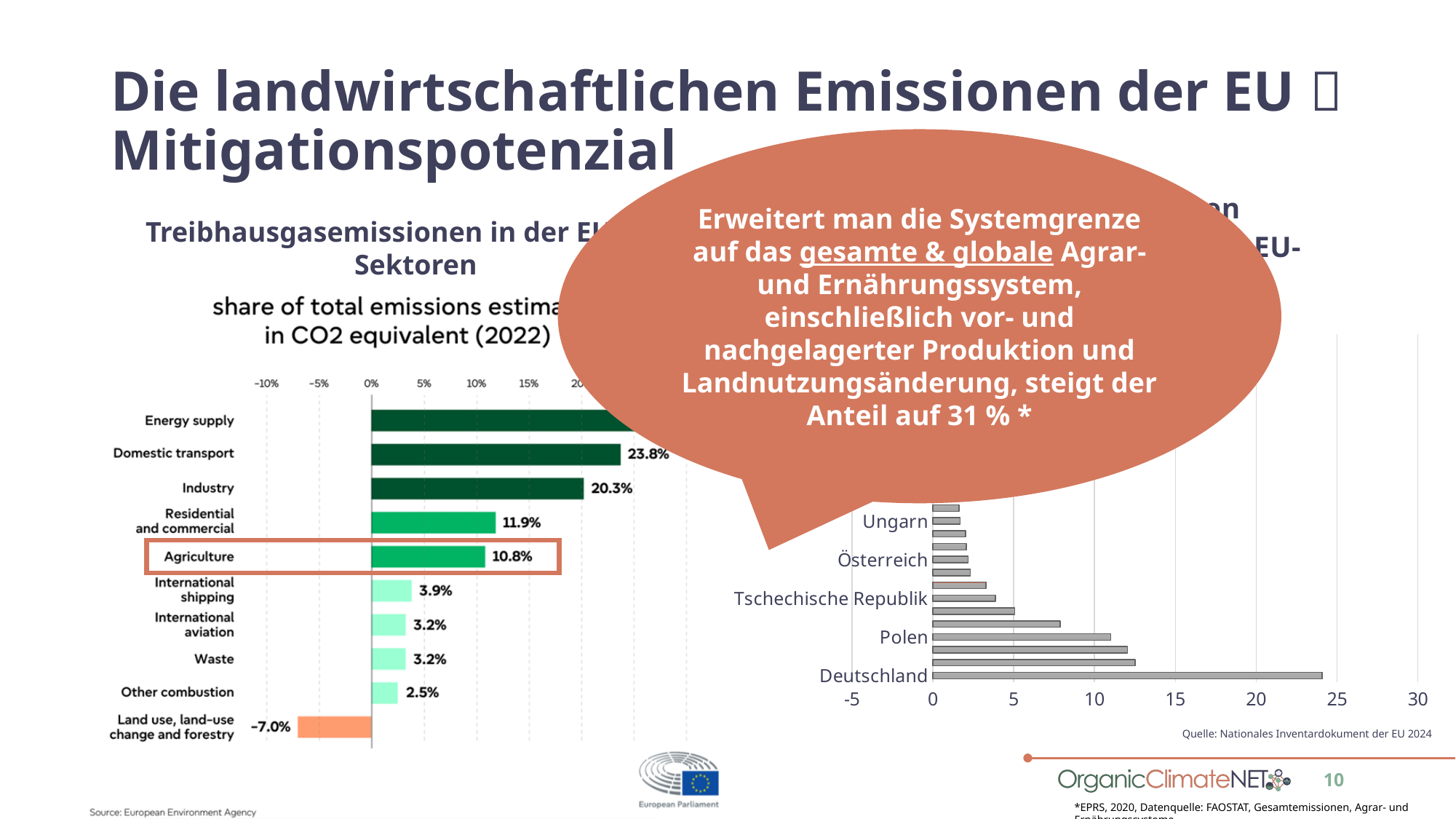
In the chart on the left, what is the value for Land use, land-use change and forestry? -7.0% In the chart on the left, which is larger: Residential and commercial or Agriculture? Residential and commercial How many sectors are shown in the chart on the left? 10 In the chart on the left, what is the difference between Domestic transport and Industry? 3.5 percentage points In the chart on the left, which sector is highlighted with an orange box? Agriculture What kind of chart is the chart on the right? bar chart In the chart on the left, what is the value for Agriculture? 10.8% In the chart on the left, is the value for Energy supply greater or less than 20%? greater In the chart on the left, what is the value for Domestic transport? 23.8% In the chart on the left, which sector has the highest share of emissions? Energy supply In the chart on the right, is the value for Deutschland greater or less than 20? greater In the chart on the left, which sector has the lowest value? Land use, land-use change and forestry